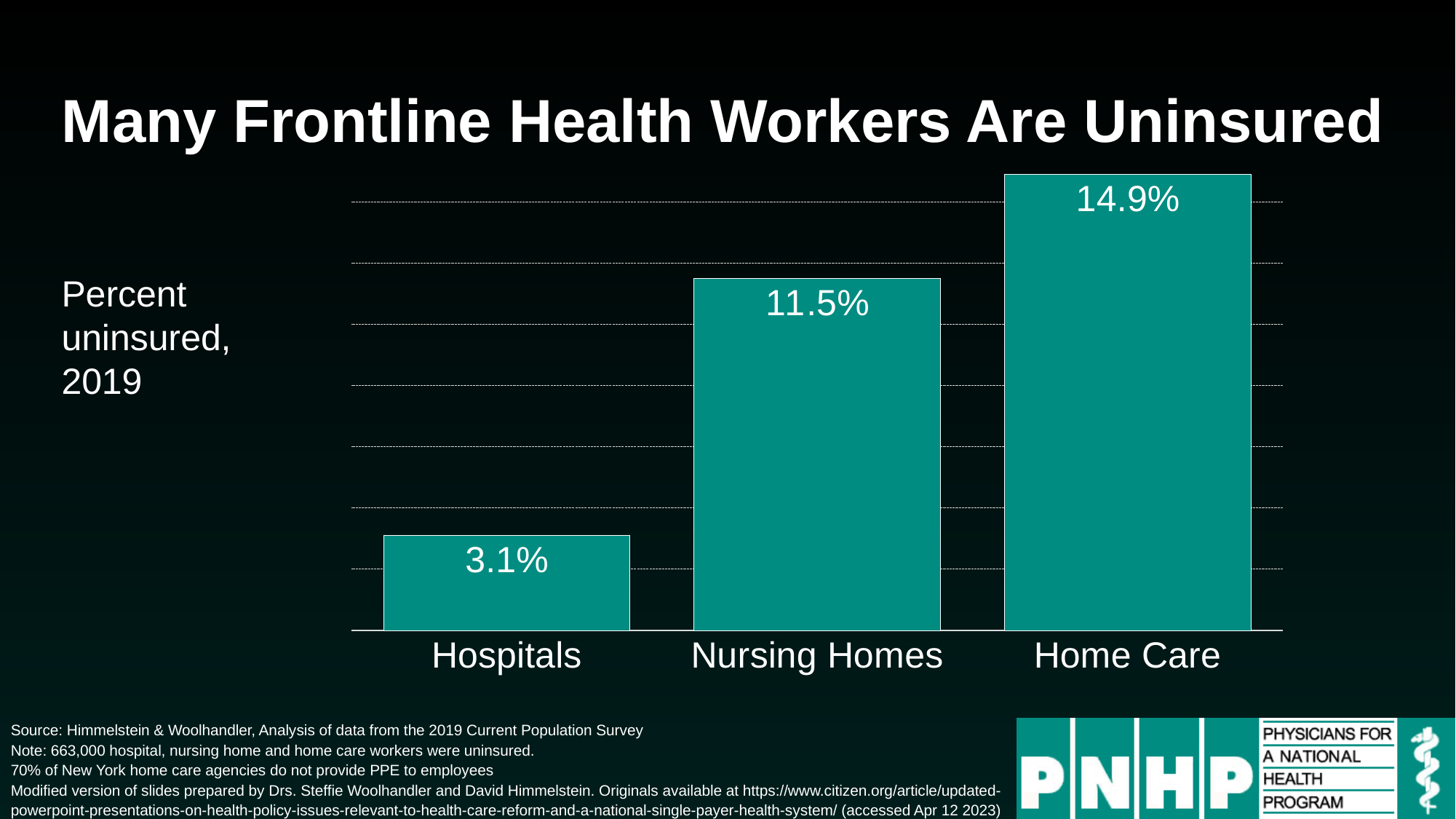
Do the values rise or fall from Hospitals to Home Care along the x axis? Rise Which category has the lowest percent uninsured? Hospitals What is the percent uninsured for Home Care? 14.9% What kind of chart is shown on the slide? Bar chart How many categories are shown in the chart? 3 Which category has the highest percent uninsured? Home Care Which has a higher percent uninsured, Nursing Homes or Hospitals? Nursing Homes What is the difference in percent uninsured between Home Care and Nursing Homes? 3.4% What is the difference in percent uninsured between Home Care and Hospitals? 11.8% What is the percent uninsured for Hospitals? 3.1% What is the percent uninsured for Nursing Homes? 11.5% What is the title of the slide? Many Frontline Health Workers Are Uninsured